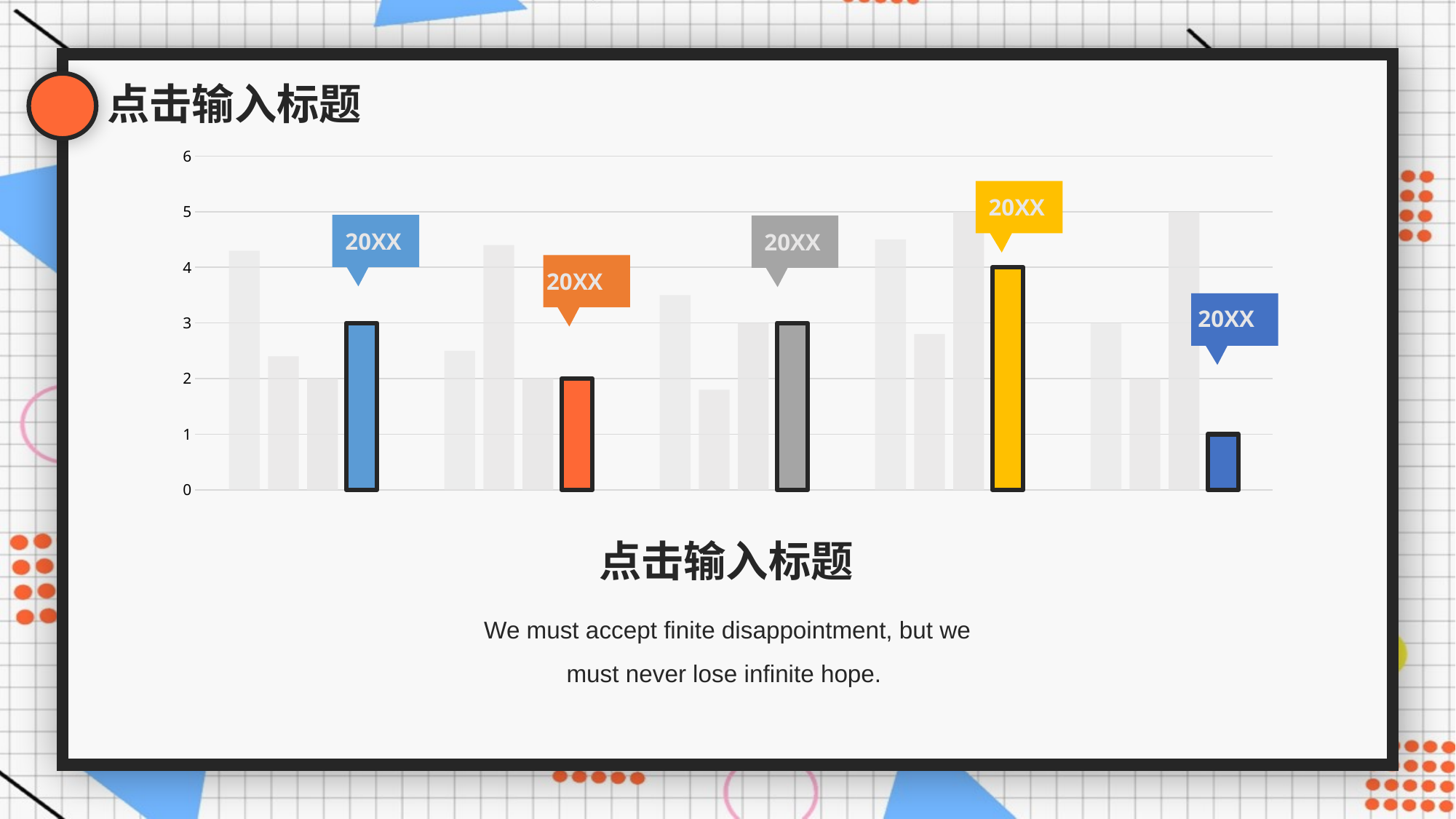
What text appears in each of the callout labels above the coloured bars? 20XX What value does the dark blue highlighted bar (the rightmost coloured bar) reach? 1 What value does the blue highlighted bar (the first coloured bar from the left) reach? 3 What value does the orange highlighted bar reach? 2 Among the five coloured highlighted bars, which colour bar is the shortest? dark blue What value does the yellow highlighted bar reach? 4 What value does the gray highlighted bar with the gray callout reach? 3 Which is larger, the orange highlighted bar or the gray highlighted bar? gray What is the difference between the yellow highlighted bar and the dark blue highlighted bar? 3 How many coloured highlighted bars with callout labels are there in the chart? 5 Among the five coloured highlighted bars, which colour bar is the tallest? yellow What kind of chart is shown on the slide? bar chart